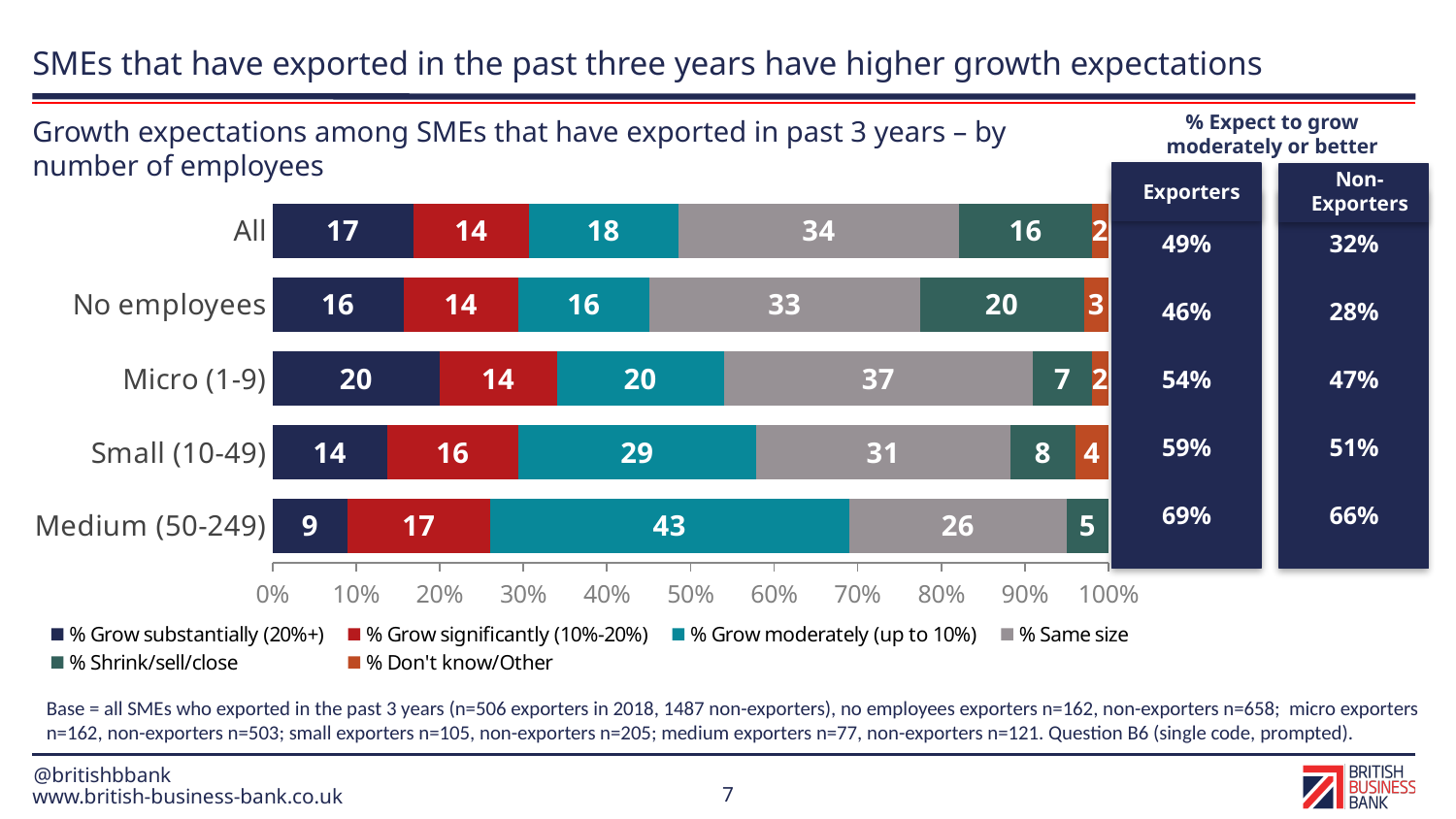
How many series does the chart legend list? 6 What is the value of % Grow significantly (10%-20%) for Small (10-49)? 16 What is the difference between the % Grow moderately (up to 10%) values for Small (10-49) and All? 11 Which has a larger % Shrink/sell/close value, No employees or Micro (1-9)? No employees What kind of chart is shown on the slide? Stacked bar chart What is the title of the chart? Growth expectations among SMEs that have exported in past 3 years – by number of employees Which category has the highest value for % Same size? Micro (1-9) How many employee-size categories are shown in the chart? 5 What is the value of % Same size for Micro (1-9)? 37 Which category has the highest value for % Grow substantially (20%+)? Micro (1-9) Which category has the lowest value for % Grow substantially (20%+)? Medium (50-249) What is the value of % Grow moderately (up to 10%) for Medium (50-249)? 43